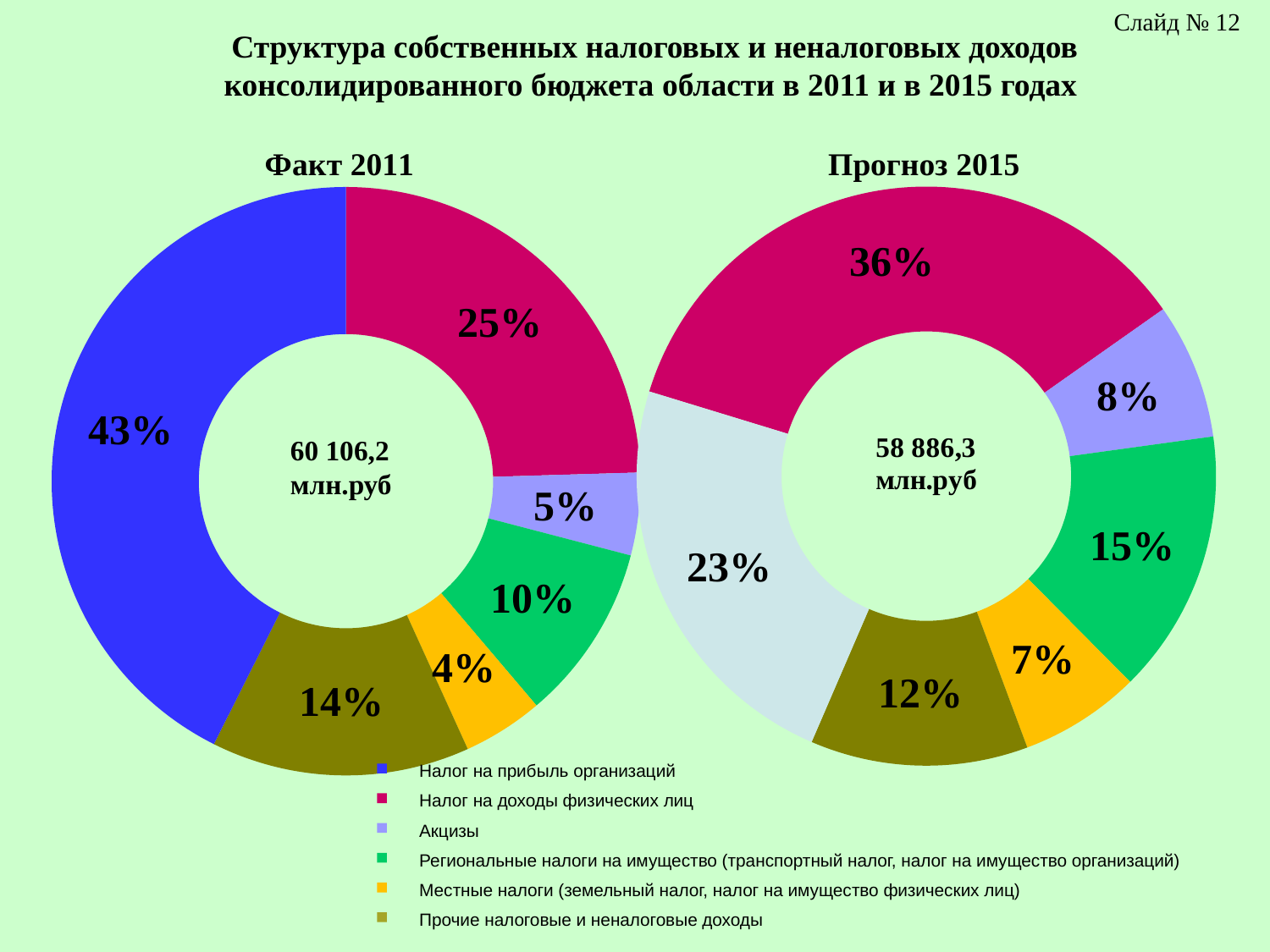
In the 'Факт 2011' chart, what share is shown for Налог на прибыль организаций? 43% In the 'Факт 2011' chart, which category has the smallest share? Местные налоги (земельный налог, налог на имущество физических лиц) What total amount is shown in the centre of the 'Факт 2011' chart? 60 106,2 млн.руб In the 'Прогноз 2015' chart, what is the largest share shown? 36% What is the difference between the share of Региональные налоги на имущество in the 'Прогноз 2015' chart and in the 'Факт 2011' chart? 5% What kind of chart is used on this slide? Pie (doughnut) chart How many entries does the legend list? 6 What total amount is shown in the centre of the 'Прогноз 2015' chart? 58 886,3 млн.руб Which is larger: the share of Прочие налоговые и неналоговые доходы in 'Факт 2011' or in 'Прогноз 2015'? Факт 2011 In the 'Факт 2011' chart, what share is shown for Налог на доходы физических лиц? 25% In the 'Прогноз 2015' chart, what share is shown for Акцизы? 8% In the 'Прогноз 2015' chart, what share is shown for Налог на доходы физических лиц? 36%